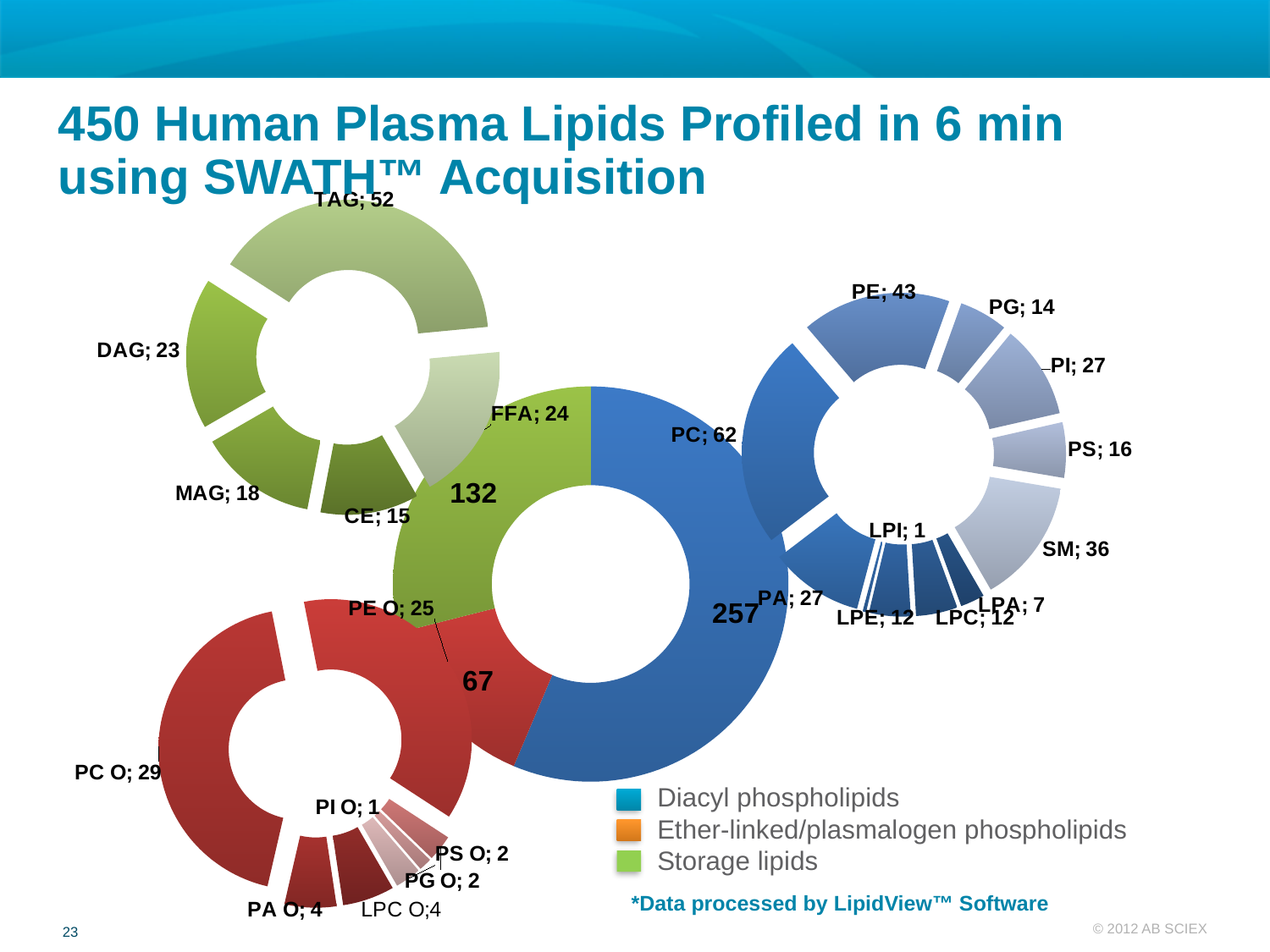
In the central donut chart, which lipid class has the smallest value? Ether-linked/plasmalogen phospholipids In the red ether-linked phospholipids donut at the bottom left, which category has the highest value? PC O In the central donut chart, what is the value for Diacyl phospholipids? 257 In the green storage lipids donut at the top left, what is the value for TAG? 52 In the green storage lipids donut at the top left, which category has the lowest value? CE How many categories are shown in the green storage lipids donut at the top left? 5 In the blue diacyl phospholipids donut on the right, which is larger, PE or SM? PE In the central donut chart, what is the difference between the Diacyl phospholipids value and the Storage lipids value? 125 In the blue diacyl phospholipids donut on the right, what is the value for PC? 62 In the central donut chart, what is the value for Storage lipids? 132 How many entries does the legend list? 3 In the central donut chart, which lipid class has the largest value? Diacyl phospholipids